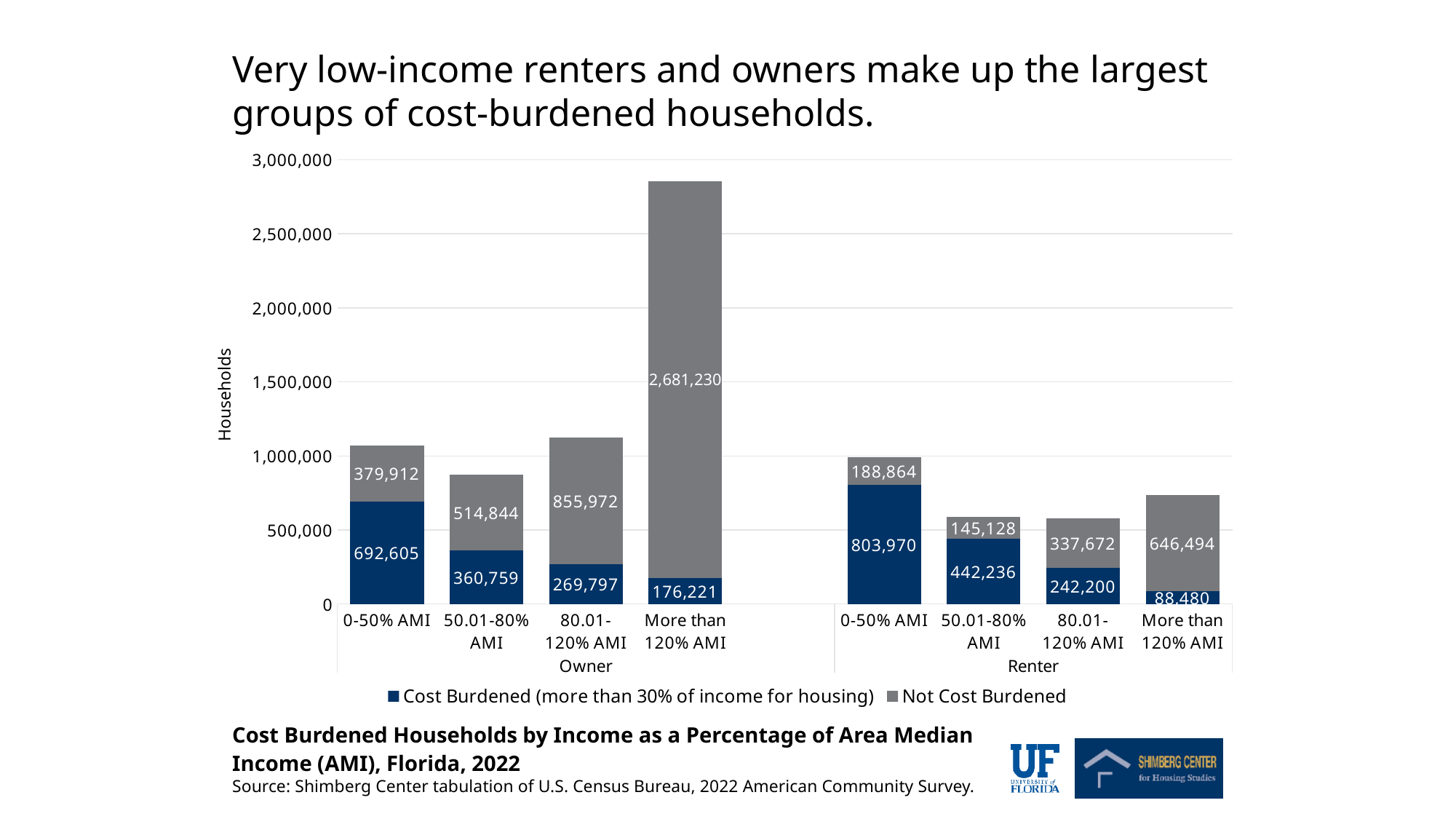
What is the number of not cost-burdened owner households at more than 120% AMI? 2,681,230 What is the number of cost-burdened owner households at 0-50% AMI? 692,605 Which income category has the lowest number of cost-burdened owner households? More than 120% AMI What is the total number of renter households at 0-50% AMI (cost burdened plus not cost burdened)? 992,834 What is the number of cost-burdened renter households at 50.01-80% AMI? 442,236 Do the cost-burdened values for owner households rise or fall as income category increases from 0-50% AMI to more than 120% AMI? Fall Which is larger: the number of cost-burdened renter households at 80.01-120% AMI or the number of cost-burdened owner households at 80.01-120% AMI? Owner households at 80.01-120% AMI How many bars (income categories across Owner and Renter) are plotted in the chart? 8 Which income category has the highest number of cost-burdened renter households? 0-50% AMI How many series does the legend list? 2 What type of chart is shown on the slide? Stacked bar chart What is the difference between cost-burdened renter households and cost-burdened owner households at 0-50% AMI? 111,365